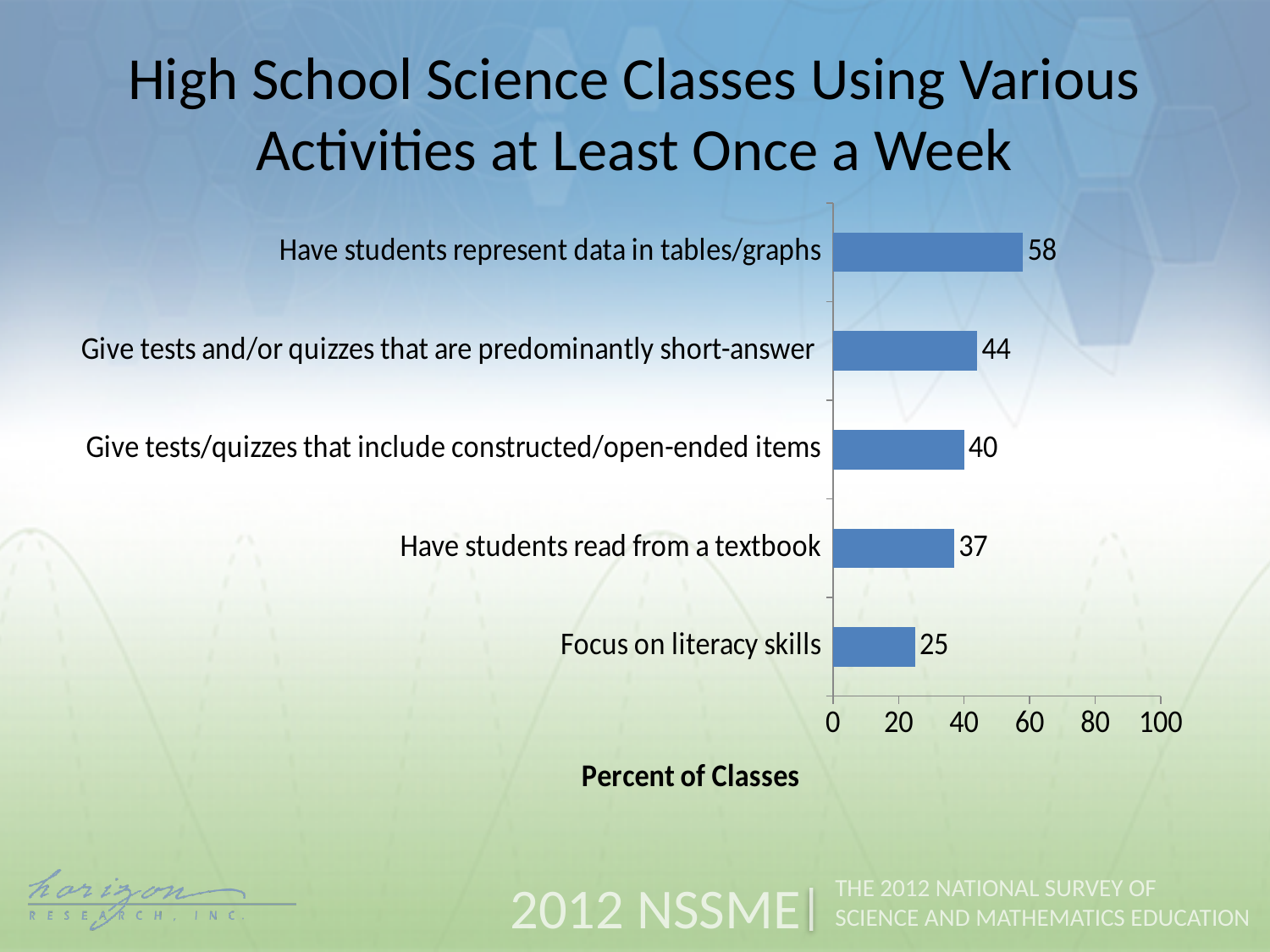
What is the difference between the values for 'Give tests and/or quizzes that are predominantly short-answer' and 'Give tests/quizzes that include constructed/open-ended items'? 4 Is the value for 'Have students represent data in tables/graphs' greater or less than 60? less What is the value for 'Have students read from a textbook'? 37 How many activities are shown in the chart? 5 What is the value for 'Focus on literacy skills'? 25 What is the label of the horizontal axis? Percent of Classes Which activity has the lowest percent of classes? Focus on literacy skills Which is larger: the value for 'Have students read from a textbook' or the value for 'Focus on literacy skills'? Have students read from a textbook What is the maximum value shown on the horizontal axis? 100 What percent of classes have students represent data in tables/graphs at least once a week? 58 Which activity has the highest percent of classes? Have students represent data in tables/graphs What kind of chart is shown on the slide? bar chart